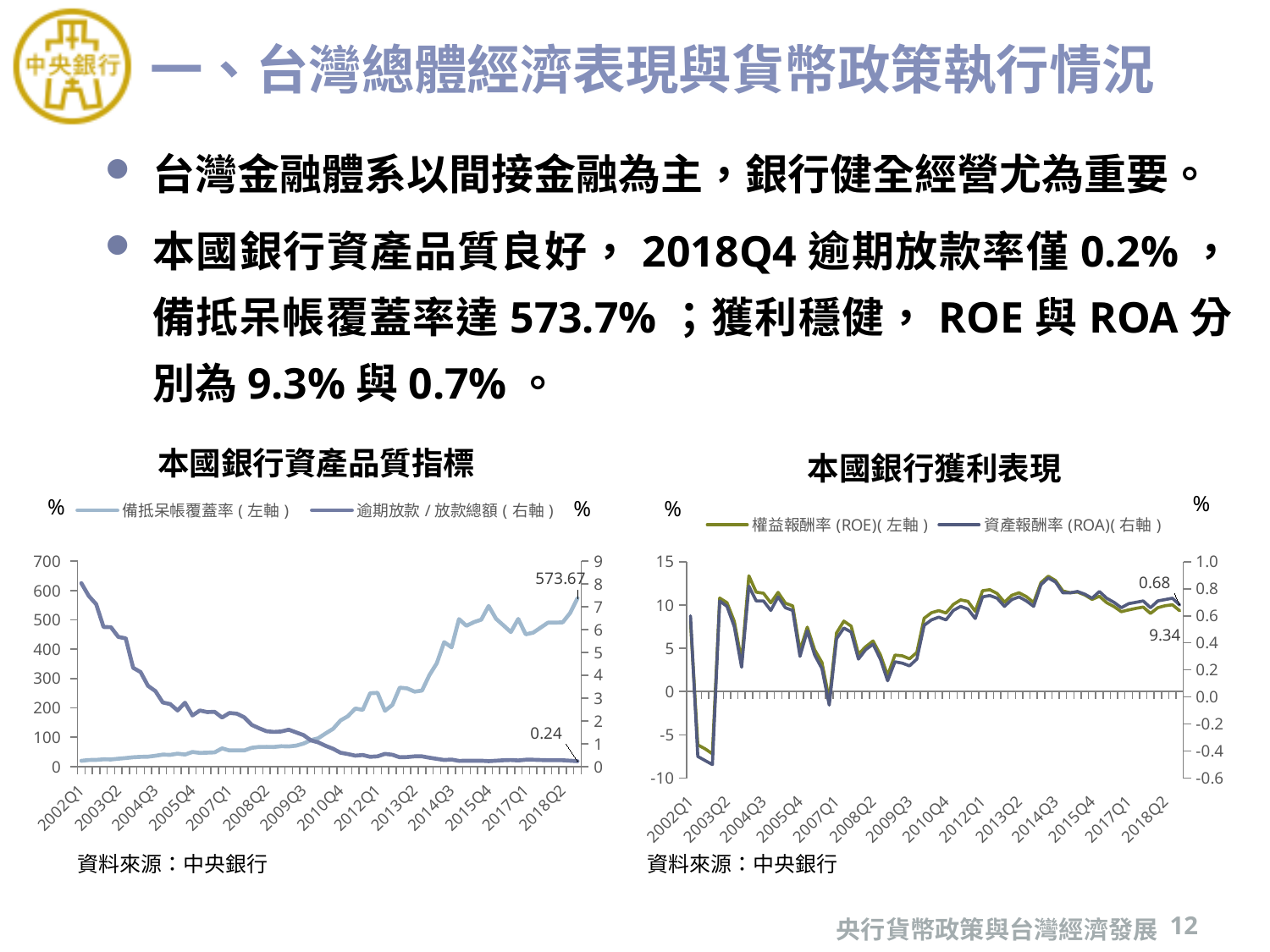
In the chart titled 本國銀行獲利表現, which series is plotted on the right axis according to the legend? 資產報酬率 (ROA) What kind of chart is the chart titled 本國銀行獲利表現? line chart In the chart titled 本國銀行資產品質指標, what is the latest labelled value of 逾期放款/放款總額? 0.24 In the chart titled 本國銀行資產品質指標, does 逾期放款/放款總額 generally rise or fall from 2002Q1 to 2018Q2? fall In the chart titled 本國銀行資產品質指標, does 備抵呆帳覆蓋率 generally rise or fall from 2002Q1 to 2018Q2? rise In the chart titled 本國銀行資產品質指標, what is the latest labelled value of 備抵呆帳覆蓋率? 573.67 In the chart titled 本國銀行獲利表現, what is the latest labelled value of 資產報酬率 (ROA)? 0.68 In the chart titled 本國銀行資產品質指標, is the value of 逾期放款/放款總額 at 2002Q1 greater or less than 7 on the right axis? greater In the chart titled 本國銀行獲利表現, what is the latest labelled value of 權益報酬率 (ROE)? 9.34 What kind of chart is the chart titled 本國銀行資產品質指標? line chart How many series does the legend of the chart titled 本國銀行獲利表現 list? 2 How many series does the legend of the chart titled 本國銀行資產品質指標 list? 2